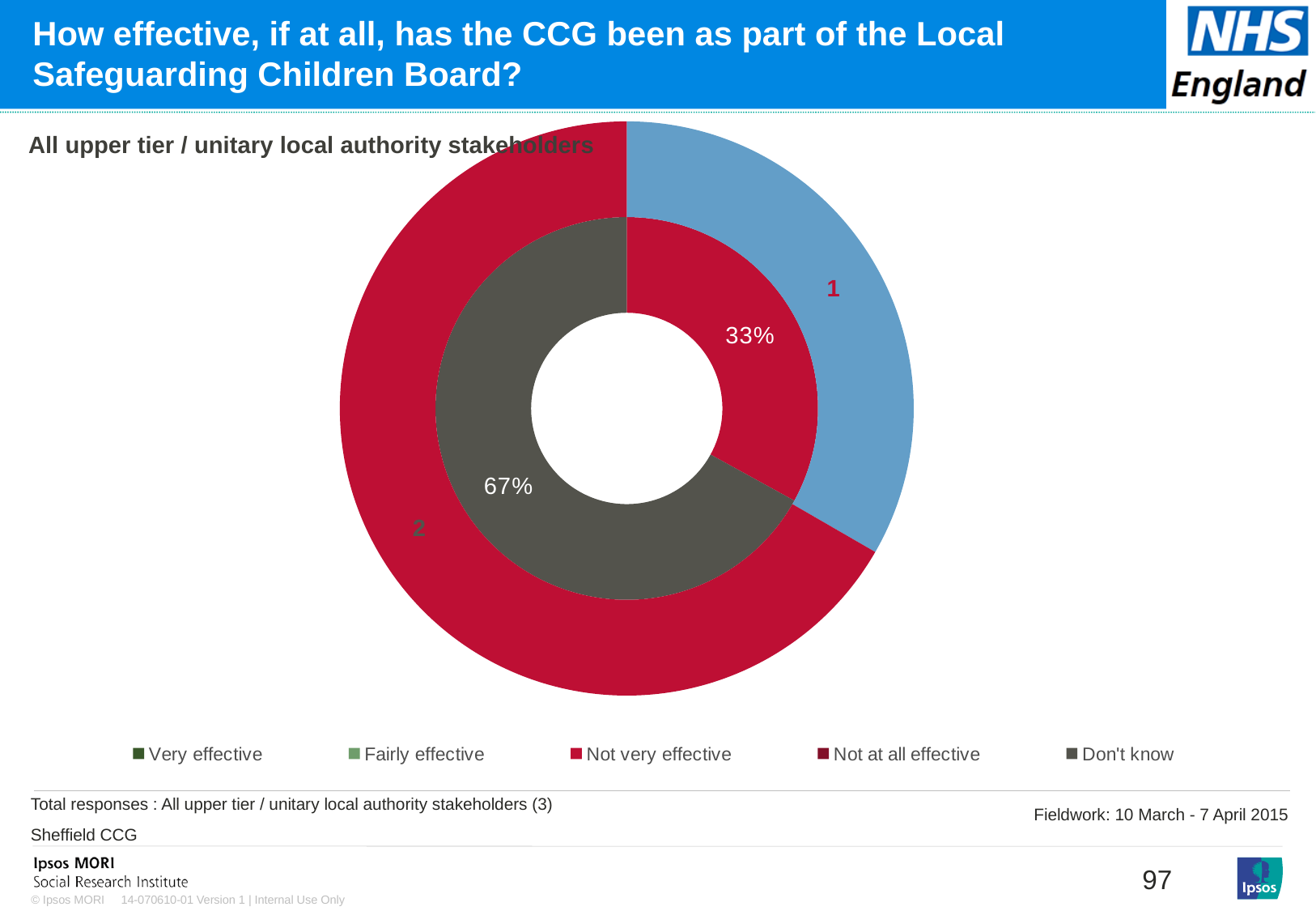
In the inner ring, which segment has the larger share: Not very effective or Don't know? Don't know What percentage is printed on the dark grey (Don't know) segment of the inner ring? 67% How many entries does the chart legend list? 5 How many total responses are reported for the chart? 3 What percentage is printed on the red (Not very effective) segment of the inner ring? 33% What number is printed on the blue segment of the outer ring? 1 What is the subtitle shown above the chart? All upper tier / unitary local authority stakeholders What kind of chart is shown on the slide? Doughnut chart What is the difference in percentage points between the Don't know (67%) and Not very effective (33%) segments of the inner ring? 34 percentage points Is the Don't know share in the inner ring greater or less than 50%? greater What number is printed on the red segment of the outer ring? 2 Which segment of the inner ring is the largest? Don't know